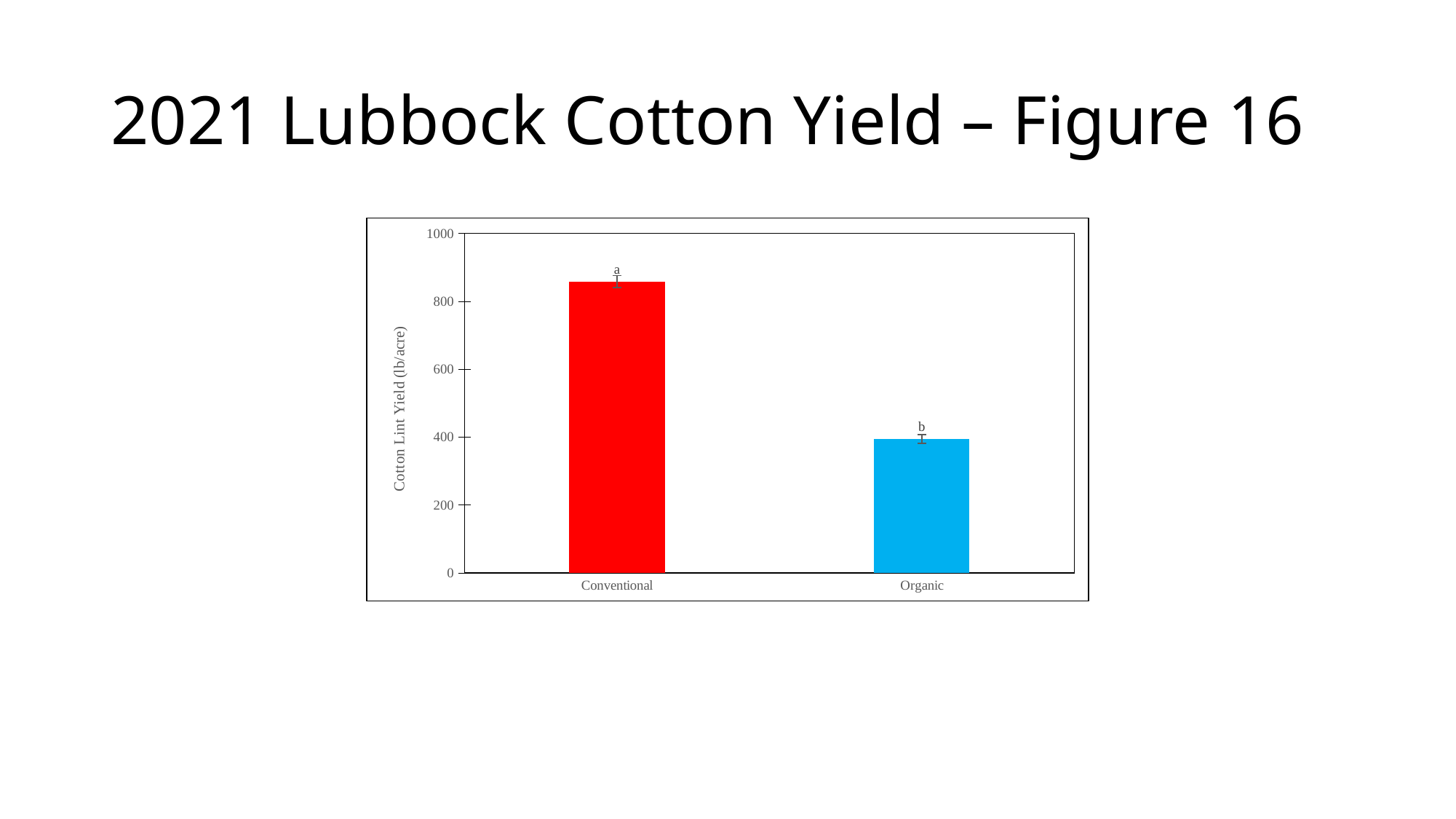
How many categories are plotted on the x axis? 2 What is the title of the y axis? Cotton Lint Yield (lb/acre) What colour is the Organic bar? blue Which has the larger cotton lint yield, Conventional or Organic? Conventional Is the value for Organic greater or less than 200? greater What kind of chart is shown on the slide? bar chart Which category has the highest cotton lint yield? Conventional Which category has the lowest cotton lint yield? Organic Is the value for Conventional greater or less than 800? greater Is the value for Conventional greater or less than 1000? less